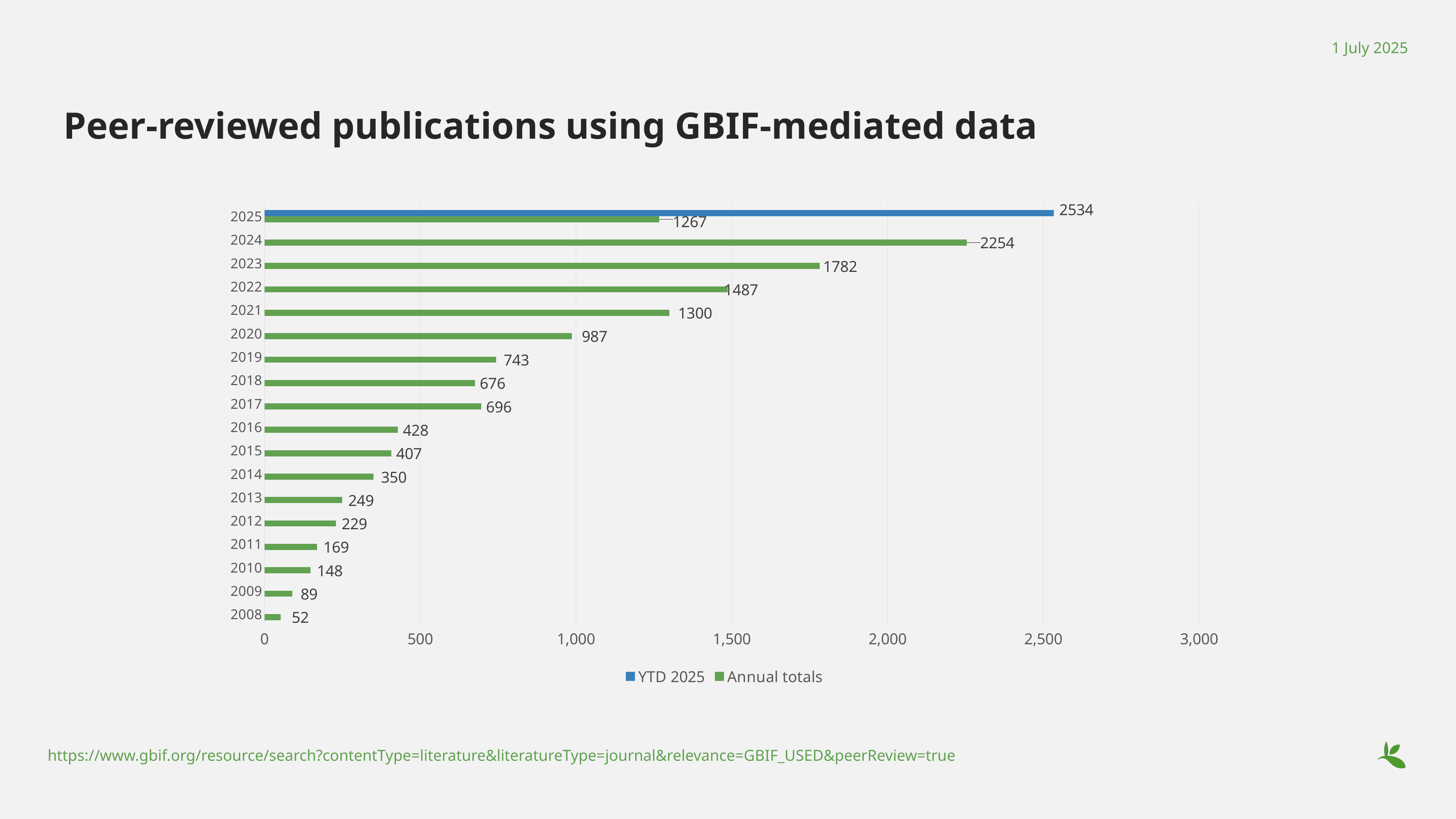
What kind of chart is shown on the slide? Bar chart What is the annual total for 2024? 2254 How many years are shown on the chart? 18 Do the annual totals generally rise or fall from 2008 to 2024? Rise How many series does the legend list? 2 Which year has the lowest annual total? 2008 What is the title of the chart? Peer-reviewed publications using GBIF-mediated data What is the YTD 2025 value shown on the chart? 2534 Which year has the highest annual total? 2024 What is the annual total for 2020? 987 Which year has the larger annual total, 2017 or 2018? 2017 What is the difference between the annual totals for 2024 and 2023? 472